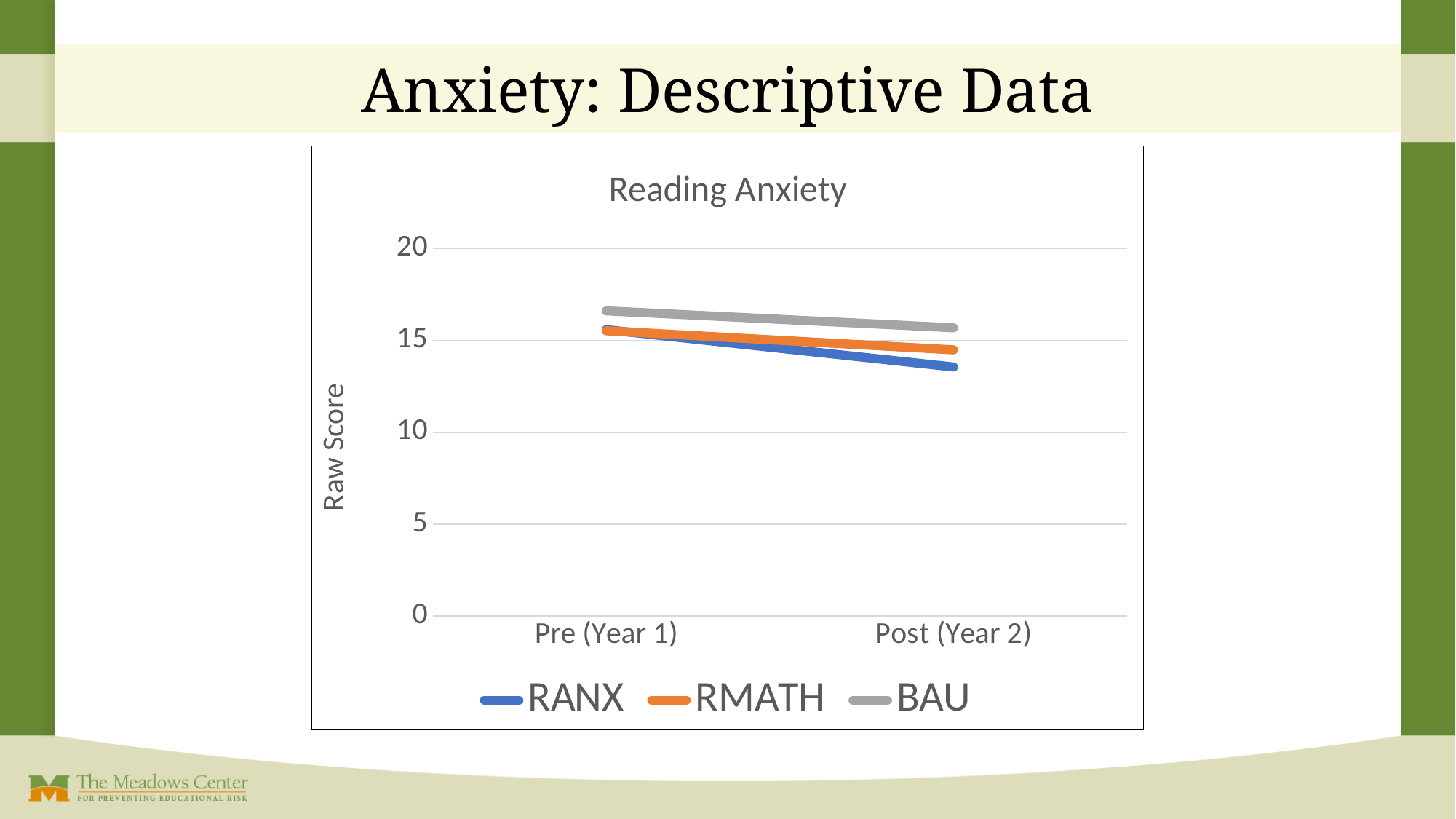
Do the BAU scores rise or fall from Pre (Year 1) to Post (Year 2)? fall Is the BAU score at Pre (Year 1) greater or less than 15? greater Which group has the lowest Reading Anxiety score at Post (Year 2)? RANX Which group has the highest Reading Anxiety score at Post (Year 2)? BAU At Post (Year 2), which is larger: the RMATH score or the RANX score? RMATH What is the label on the y axis of the Reading Anxiety chart? Raw Score Is the RANX score at Post (Year 2) greater or less than 15? less How many time points are shown on the x axis of the Reading Anxiety chart? 2 What kind of chart is shown on the slide? line chart Which group has the highest Reading Anxiety score at Pre (Year 1)? BAU Do the Reading Anxiety scores rise or fall from Pre (Year 1) to Post (Year 2) for the RANX group? fall How many series does the legend of the Reading Anxiety chart list? 3